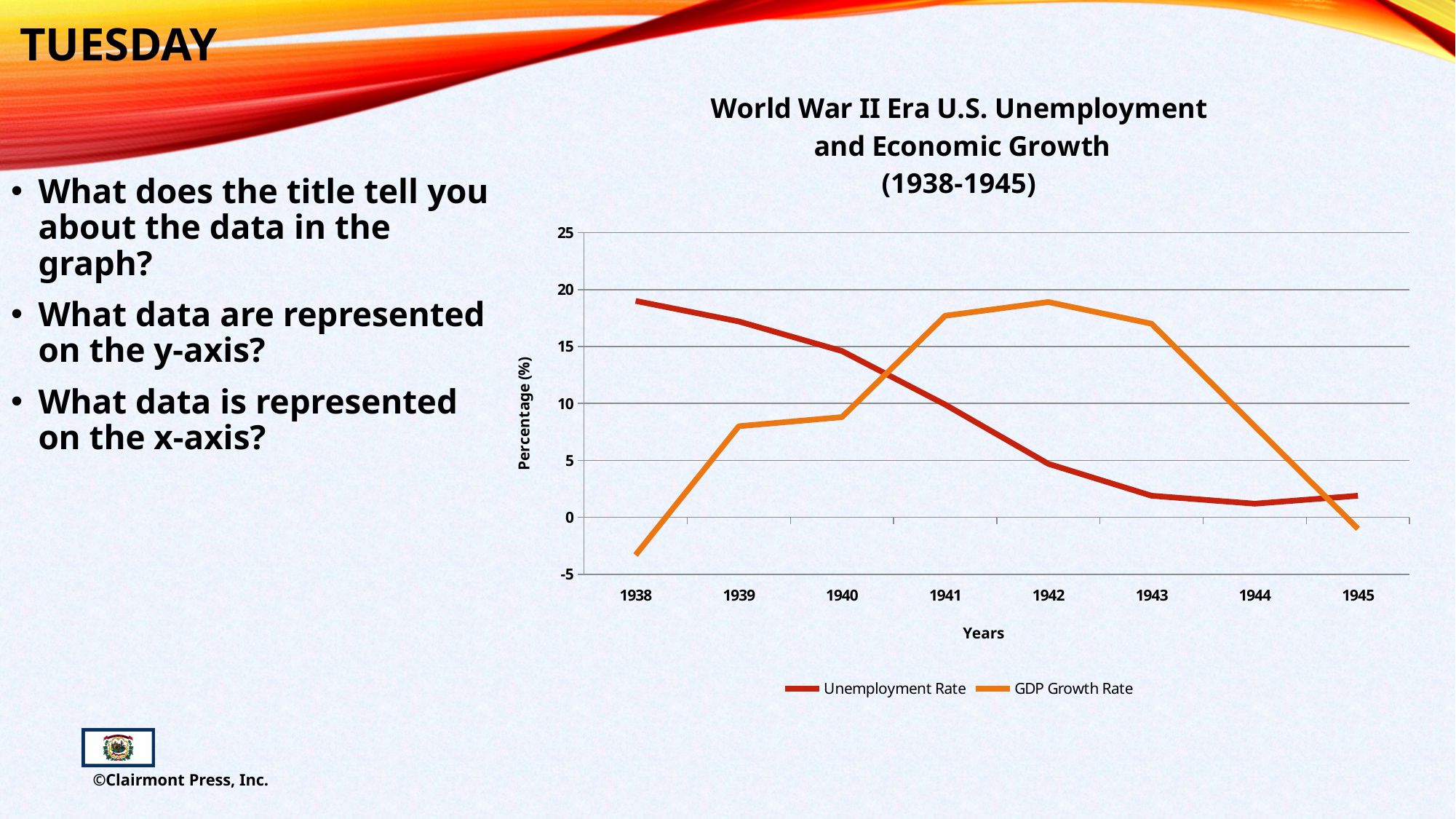
Is the GDP Growth Rate in 1938 greater or less than 0? less Does the Unemployment Rate generally rise or fall from 1938 to 1944? fall How many series does the legend list? 2 Is the Unemployment Rate in 1940 greater or less than 10? greater Which is larger in 1942, the Unemployment Rate or the GDP Growth Rate? GDP Growth Rate How many years are plotted along the x axis? 8 What kind of chart is shown on the slide? line chart In which year is the GDP Growth Rate lowest? 1938 In which year is the GDP Growth Rate highest? 1942 What label is shown on the y axis of the chart? Percentage (%) Is the GDP Growth Rate in 1941 greater or less than 15? greater In which year is the Unemployment Rate highest? 1938